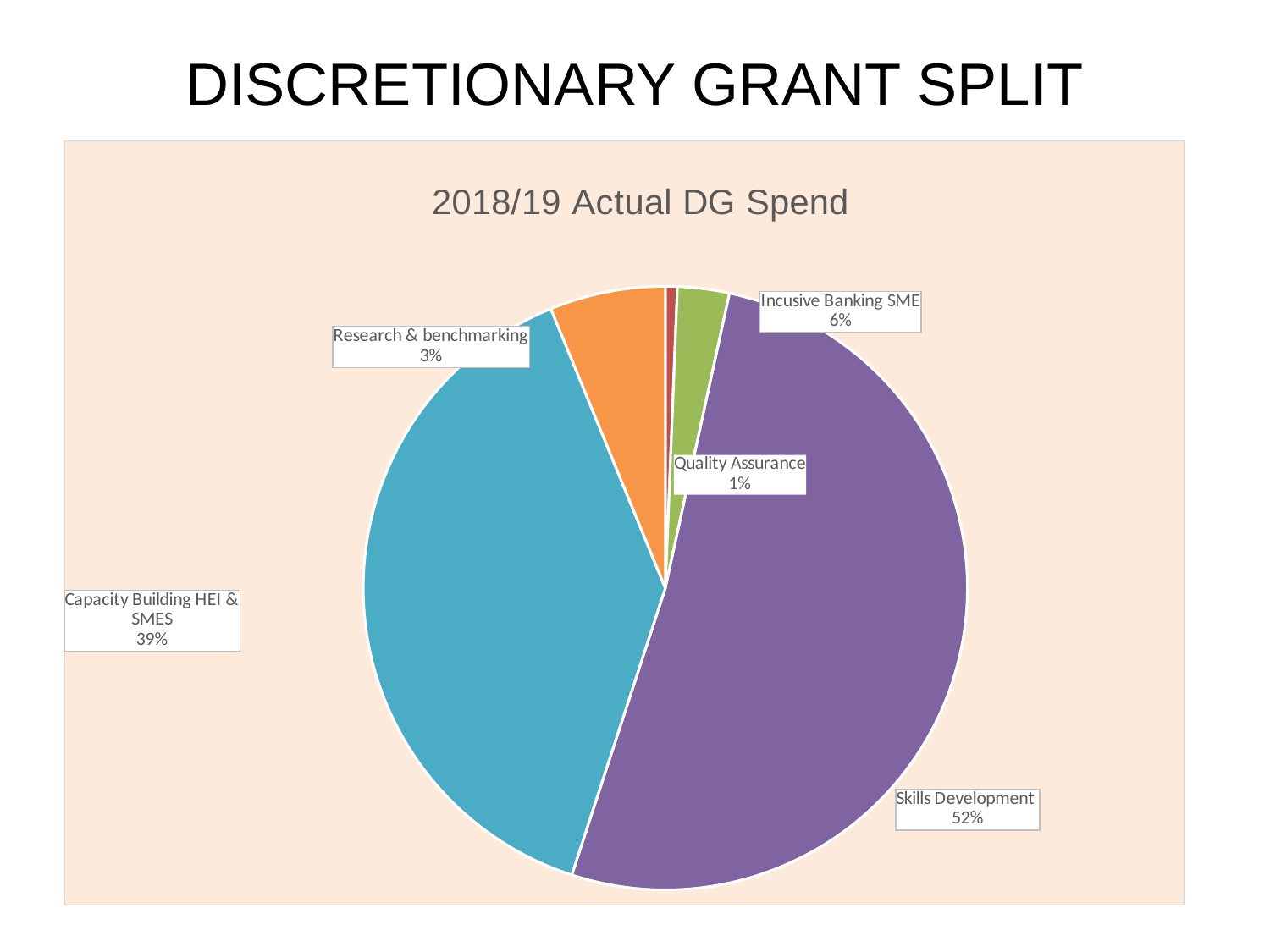
Which category has the smallest share of the 2018/19 Actual DG Spend? Quality Assurance Which has the larger share, Incusive Banking SME or Research & benchmarking? Incusive Banking SME Which category has the largest share of the 2018/19 Actual DG Spend? Skills Development How many categories are labelled in the pie chart? 5 What percentage is shown for Research & benchmarking? 3% What is the title of the chart? 2018/19 Actual DG Spend What percentage is shown for Quality Assurance? 1% What kind of chart is shown on the slide? Pie chart What percentage is shown for Incusive Banking SME? 6% What percentage is shown for Capacity Building HEI & SMES? 39% How many percentage points larger is the Skills Development share than the Capacity Building HEI & SMES share? 13 percentage points What share of the 2018/19 Actual DG Spend went to Skills Development? 52%